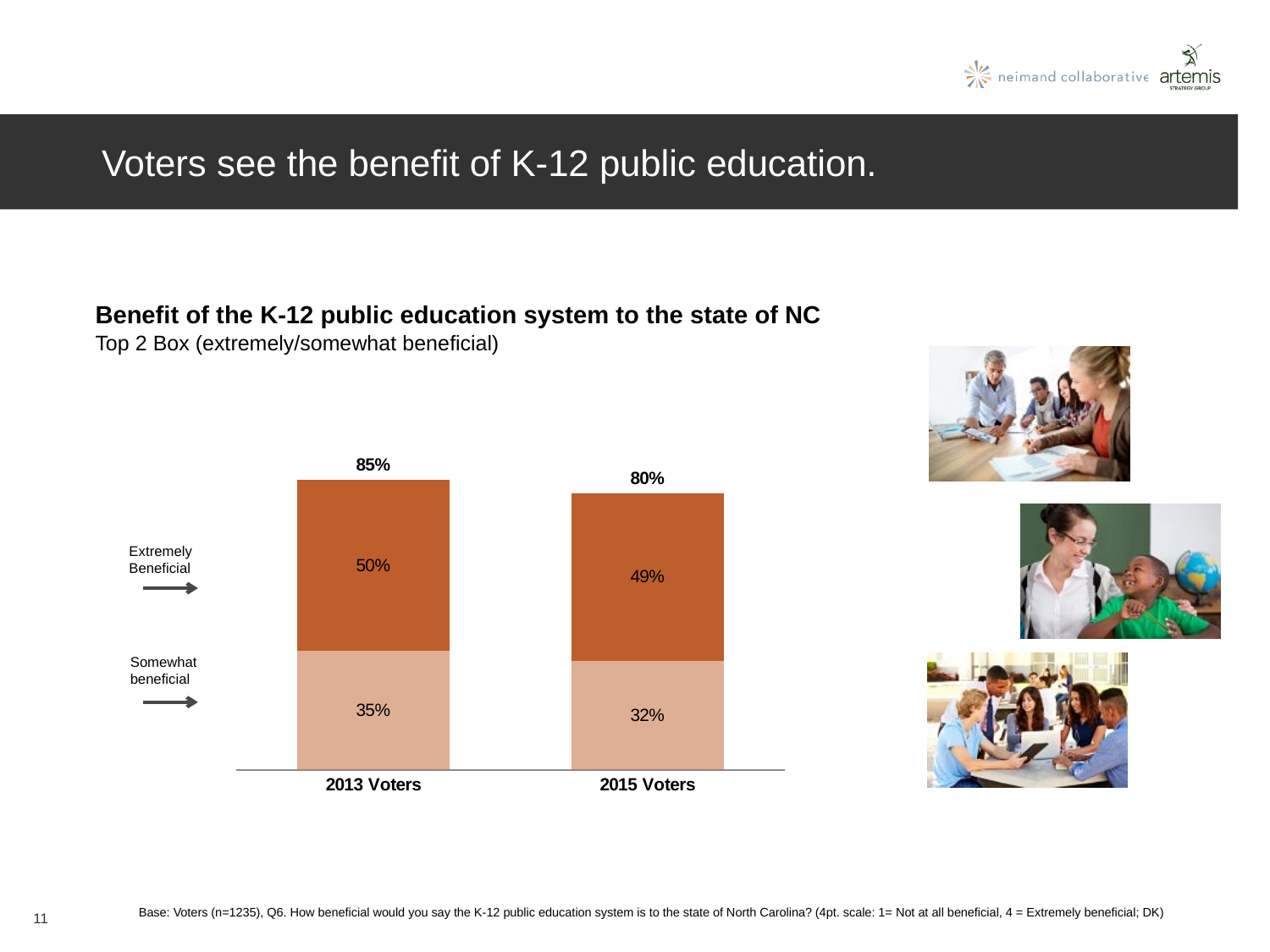
What is the difference between the Top 2 Box totals for 2013 Voters and 2015 Voters? 5% What percentage of 2013 Voters rated the K-12 public education system as Extremely Beneficial? 50% What is the Top 2 Box total for 2015 Voters? 80% What kind of chart is shown on the slide? Stacked bar chart Does the Top 2 Box total rise or fall from 2013 Voters to 2015 Voters? Fall How many voter groups are shown on the x axis of the chart? 2 What percentage of 2015 Voters rated the K-12 public education system as Somewhat beneficial? 32% What is the difference between the Somewhat beneficial values for 2013 Voters and 2015 Voters? 3% Which voter group has the higher Top 2 Box total, 2013 Voters or 2015 Voters? 2013 Voters What is the Top 2 Box total for 2013 Voters? 85% Which segment is larger for 2015 Voters, Extremely Beneficial or Somewhat beneficial? Extremely Beneficial What is the title of the chart? Benefit of the K-12 public education system to the state of NC